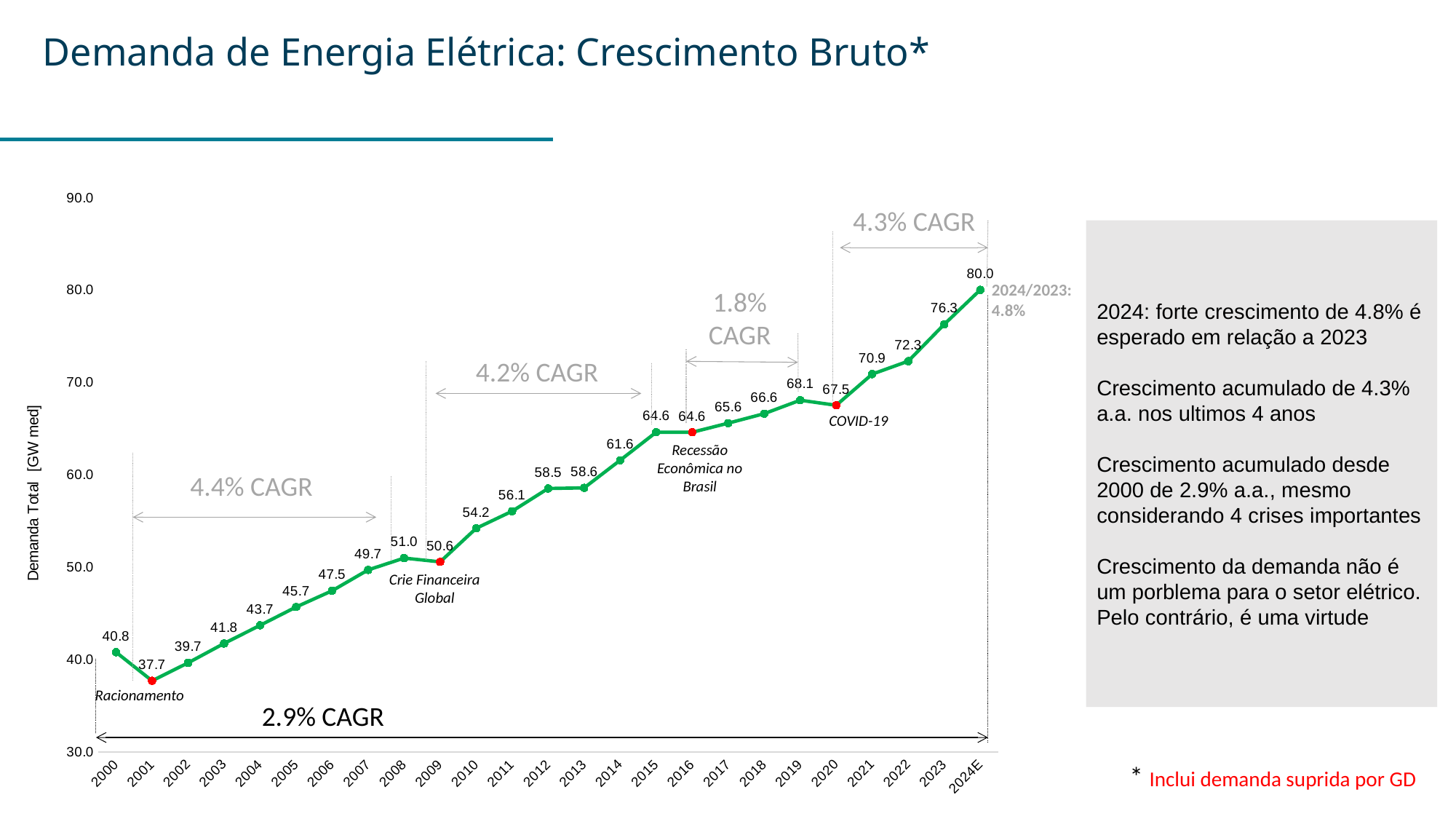
Is the value for 2014 greater or less than 60.0? greater What is the difference between the values for 2024E and 2023? 3.7 What is the value plotted for 2020, the point labelled COVID-19? 67.5 Which is larger, the value for 2019 or the value for 2020? 2019 What is the value plotted for 2024E? 80.0 What is the value plotted for 2001? 37.7 Which year has the lowest plotted value? 2001 How many years are plotted on the x axis? 25 What kind of chart is shown on the slide? line chart What is the label of the vertical axis? Demanda Total [GW med] Which year has the highest plotted value? 2024E What is the value plotted for 2009? 50.6